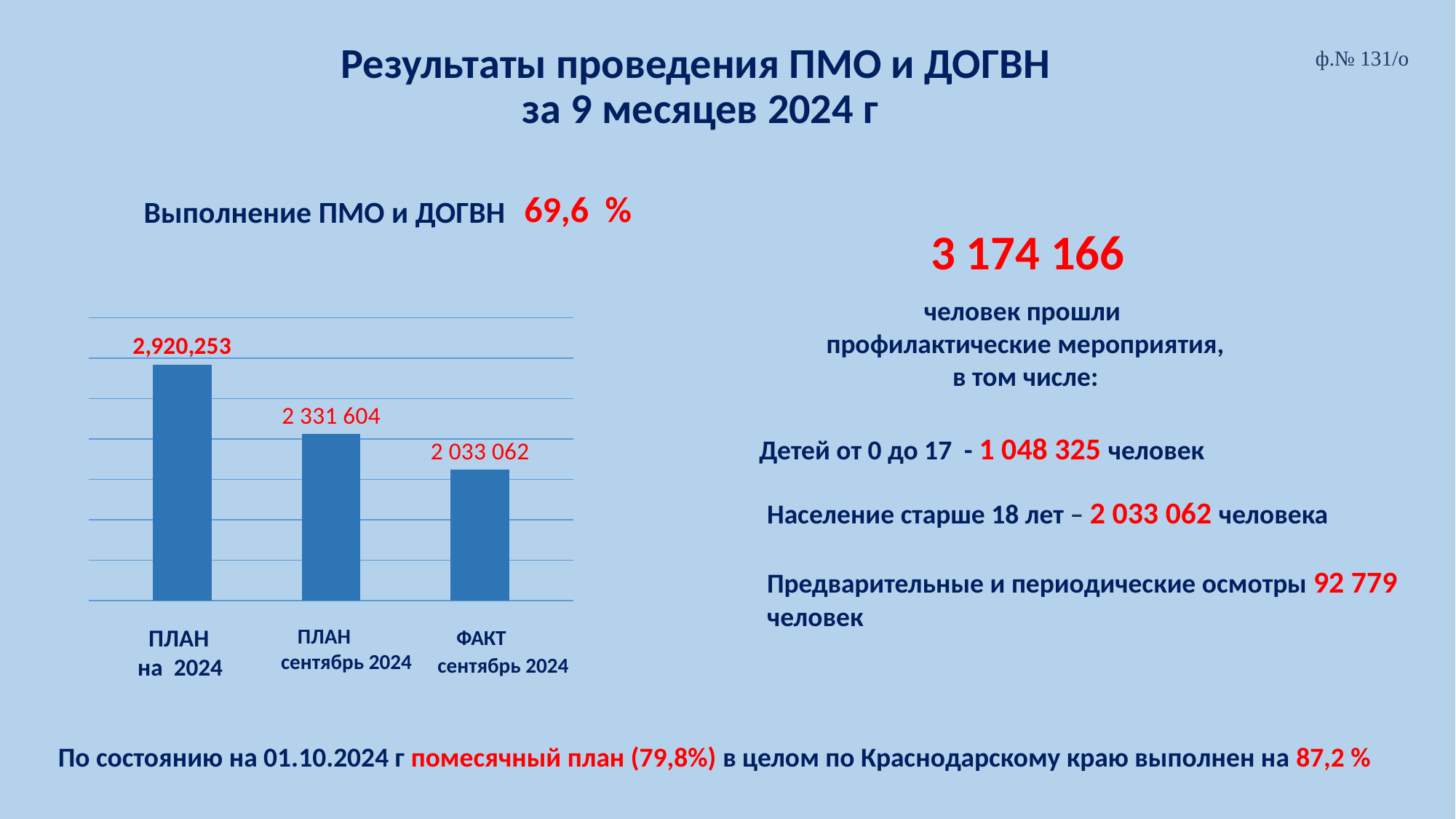
Which is larger: the "ПЛАН сентябрь 2024" bar or the "ФАКТ сентябрь 2024" bar? ПЛАН сентябрь 2024 Which category has the lowest bar in the chart? ФАКТ сентябрь 2024 What is the value of the bar labelled "ПЛАН на 2024"? 2,920,253 What colour are the bars in the chart? Blue How many bars are shown in the chart? 3 What is the difference between the "ПЛАН сентябрь 2024" bar and the "ФАКТ сентябрь 2024" bar? 298 542 What is the value of the bar labelled "ФАКТ сентябрь 2024"? 2 033 062 What is the value of the bar labelled "ПЛАН сентябрь 2024"? 2 331 604 What type of chart is shown on the slide? Bar chart Which category has the highest bar in the chart? ПЛАН на 2024 What is the difference between the "ПЛАН на 2024" bar and the "ПЛАН сентябрь 2024" bar? 588 649 Do the bar values rise or fall from left to right across the chart? Fall